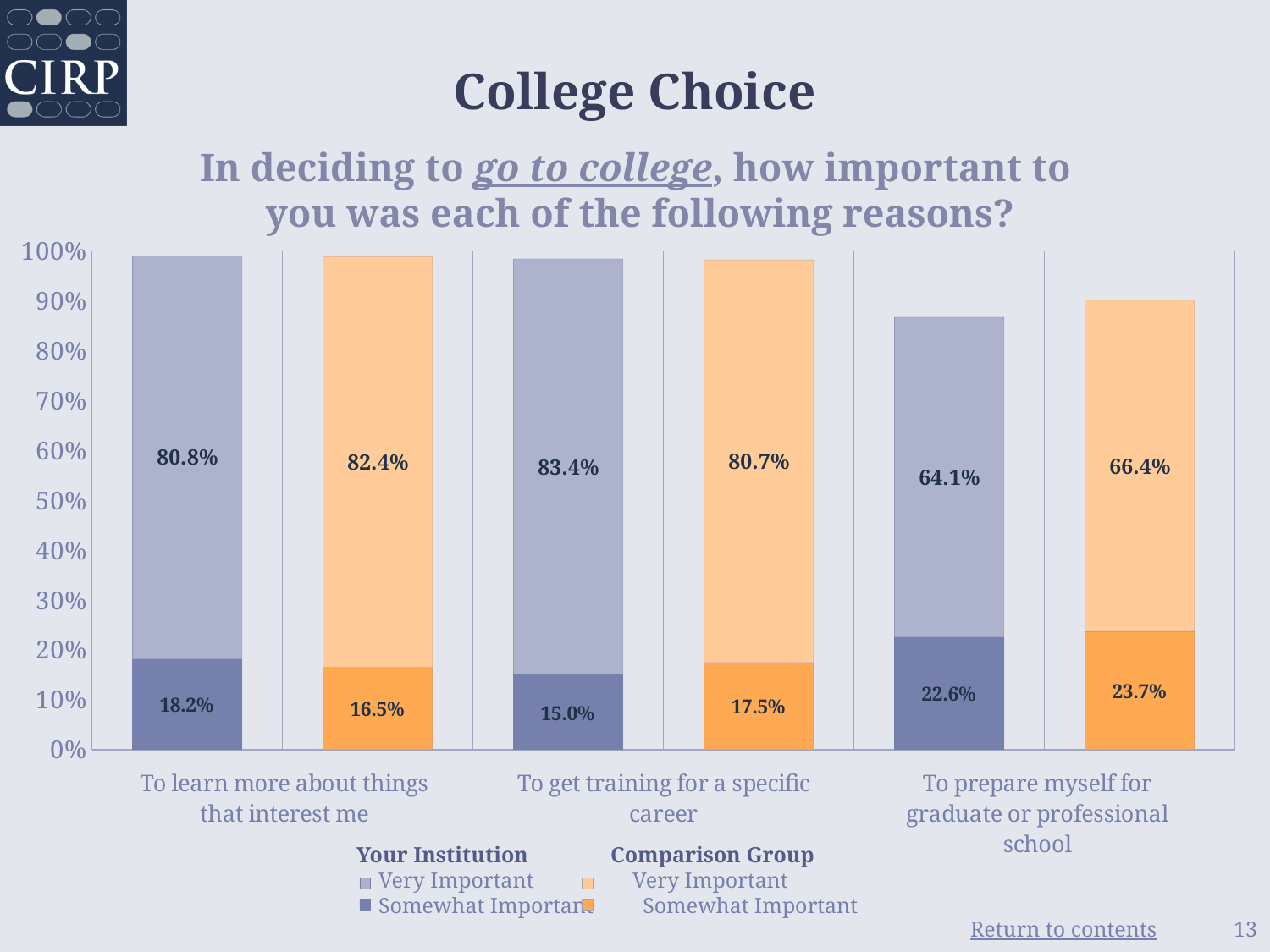
What is the combined Very Important and Somewhat Important total for Your Institution on "To prepare myself for graduate or professional school"? 86.7% How many series does the chart legend list? 4 What is the combined Very Important and Somewhat Important total for the Comparison Group on "To learn more about things that interest me"? 98.9% How many reasons (categories) are shown on the x axis of the chart? 3 Which reason has the lowest Very Important percentage for the Comparison Group? To prepare myself for graduate or professional school What is the Very Important percentage for the Comparison Group on "To get training for a specific career"? 80.7% What percentage of Your Institution respondents rated "To learn more about things that interest me" as Very Important? 80.8% Which reason has the highest Very Important percentage for Your Institution? To get training for a specific career What is the difference between the Very Important percentages for Your Institution and the Comparison Group on "To get training for a specific career"? 2.7% What kind of chart is shown on the slide? Stacked bar chart For "To prepare myself for graduate or professional school", which group has the larger Very Important percentage, Your Institution or the Comparison Group? Comparison Group What percentage of the Comparison Group rated "To prepare myself for graduate or professional school" as Somewhat Important? 23.7%